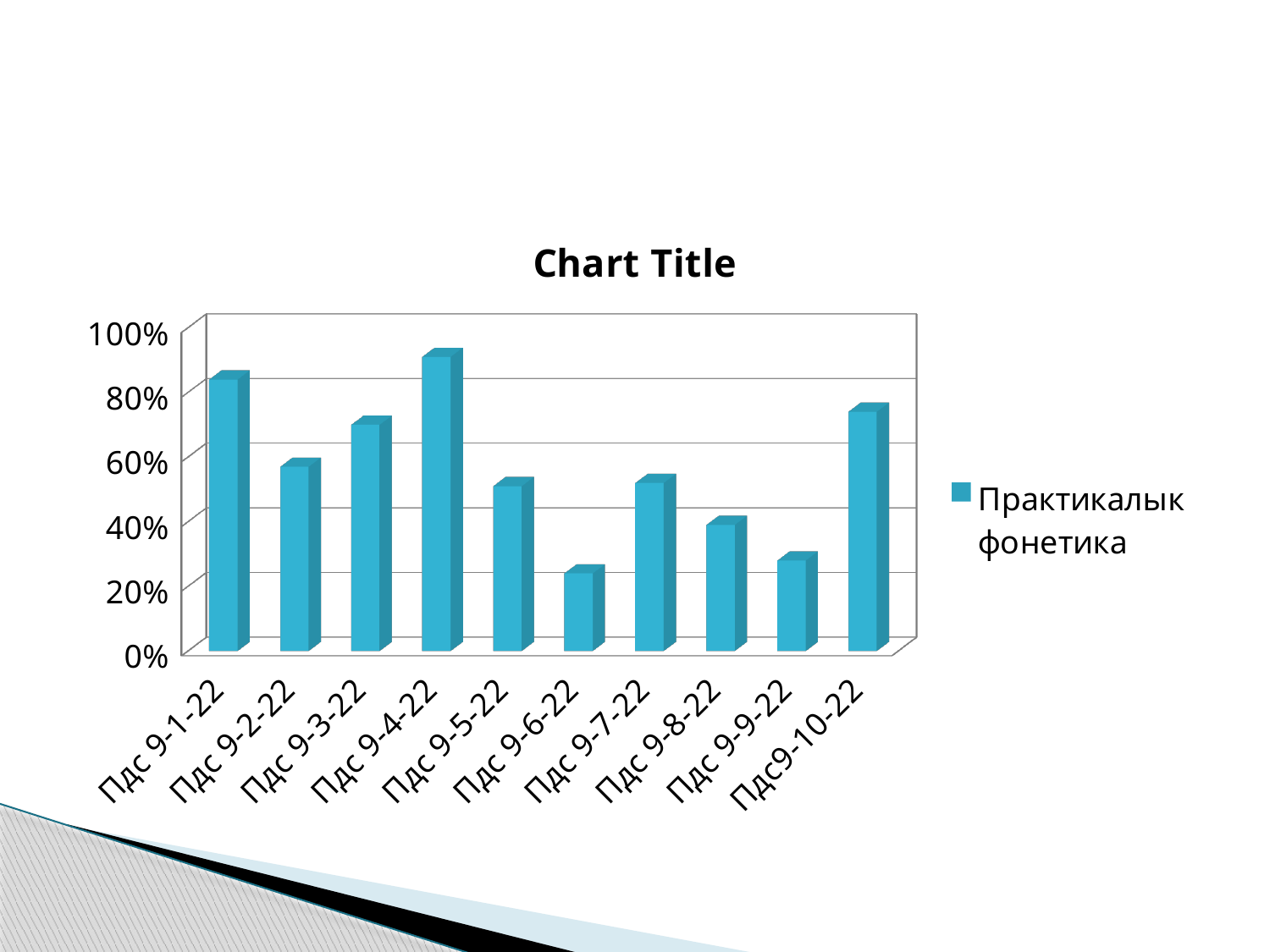
Is the value for Пдс9-10-22 greater or less than 60%? greater What kind of chart is shown on the slide? bar chart Is the value for Пдс 9-9-22 greater or less than 40%? less How many categories are shown on the x axis of the chart? 10 What series name is shown in the chart's legend? Практикалык фонетика Is the value for Пдс 9-1-22 greater or less than 60%? greater How many series does the chart's legend list? 1 Which has the larger value, Пдс 9-3-22 or Пдс 9-8-22? Пдс 9-3-22 Which category has the highest bar in the chart? Пдс 9-4-22 Which has the larger value, Пдс 9-1-22 or Пдс 9-2-22? Пдс 9-1-22